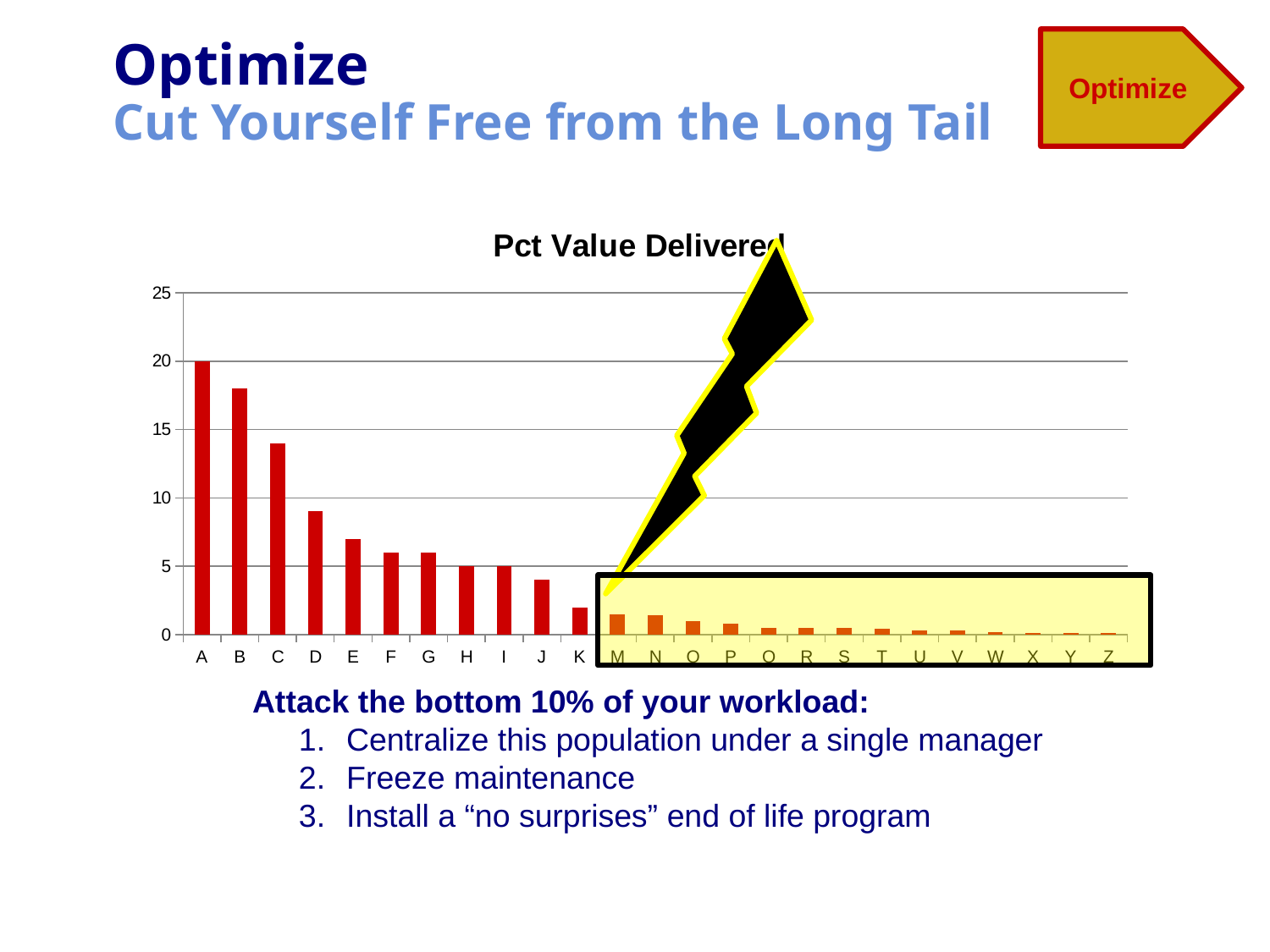
What is the value for category A? 20 Which category has the highest value in the chart? A What is the title of the chart? Pct Value Delivered What kind of chart is shown on the slide? bar chart Is the value for D greater or less than 10? less Which is larger, the value for A or the value for C? A Which is larger, the value for D or the value for J? D Is the value for B greater or less than 15? greater Is the value for K greater or less than 5? less What is the value for category H? 5 Do the values rise or fall moving from A toward Z along the x axis? fall